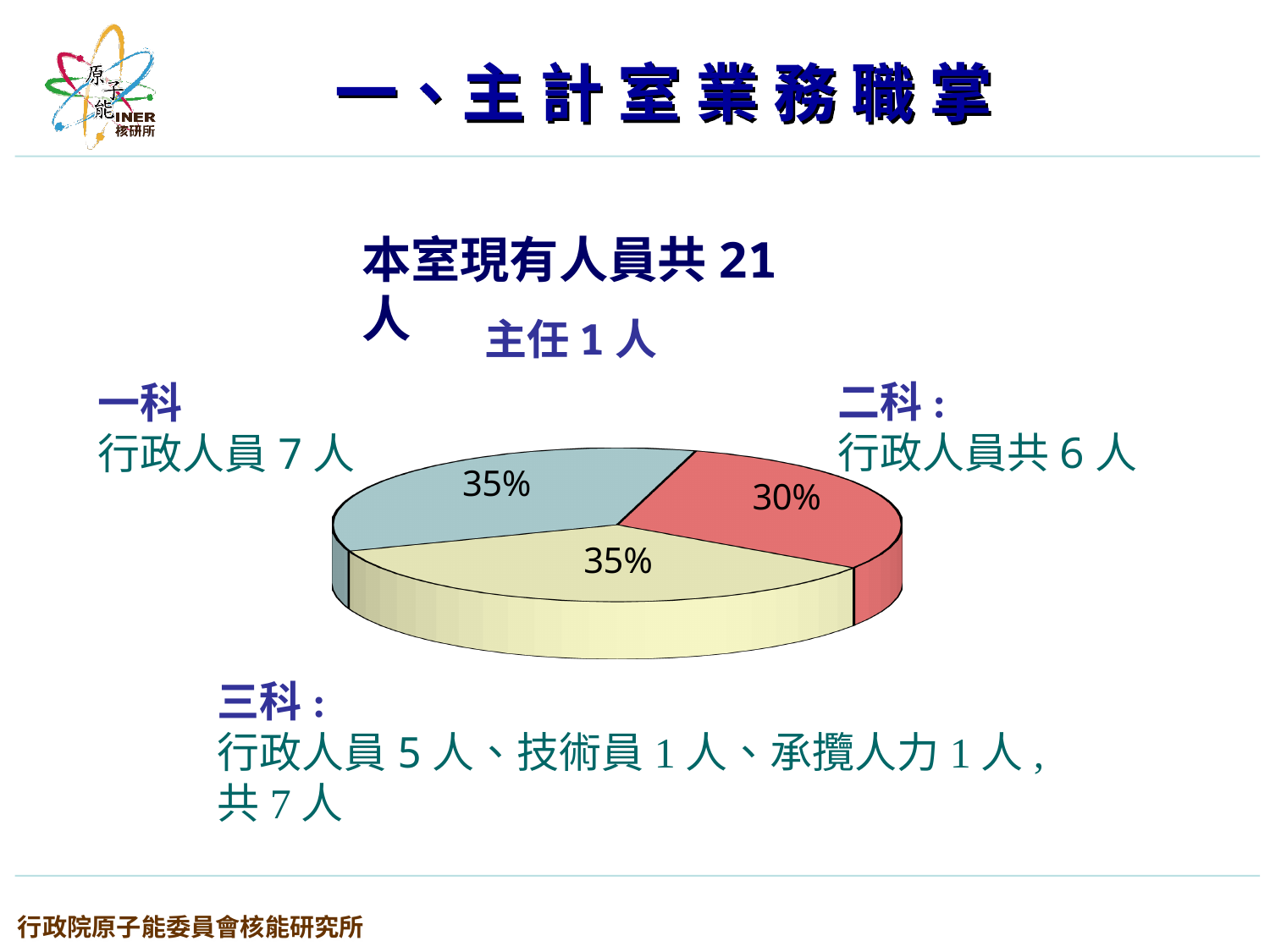
Which slice of the pie chart is the smallest? the red slice (30%) What percentage is shown on the yellow slice at the bottom of the pie chart? 35% What kind of chart is shown on the slide? pie chart According to the heading above the pie chart, how many staff does the office have in total? 21 人 According to the text next to the pie chart, how many people does 二科 have in total? 6 人 What is the combined percentage of the two 35% slices? 70% What is the difference in percentage points between the red slice and the yellow slice? 5 What percentage of the pie does the red slice represent? 30% What percentage is shown on the blue-grey slice at the upper left of the pie chart? 35% How many slices does the pie chart have? 3 Is the red slice larger or smaller than the yellow slice? smaller What percentage is shown on the red slice of the pie chart? 30%